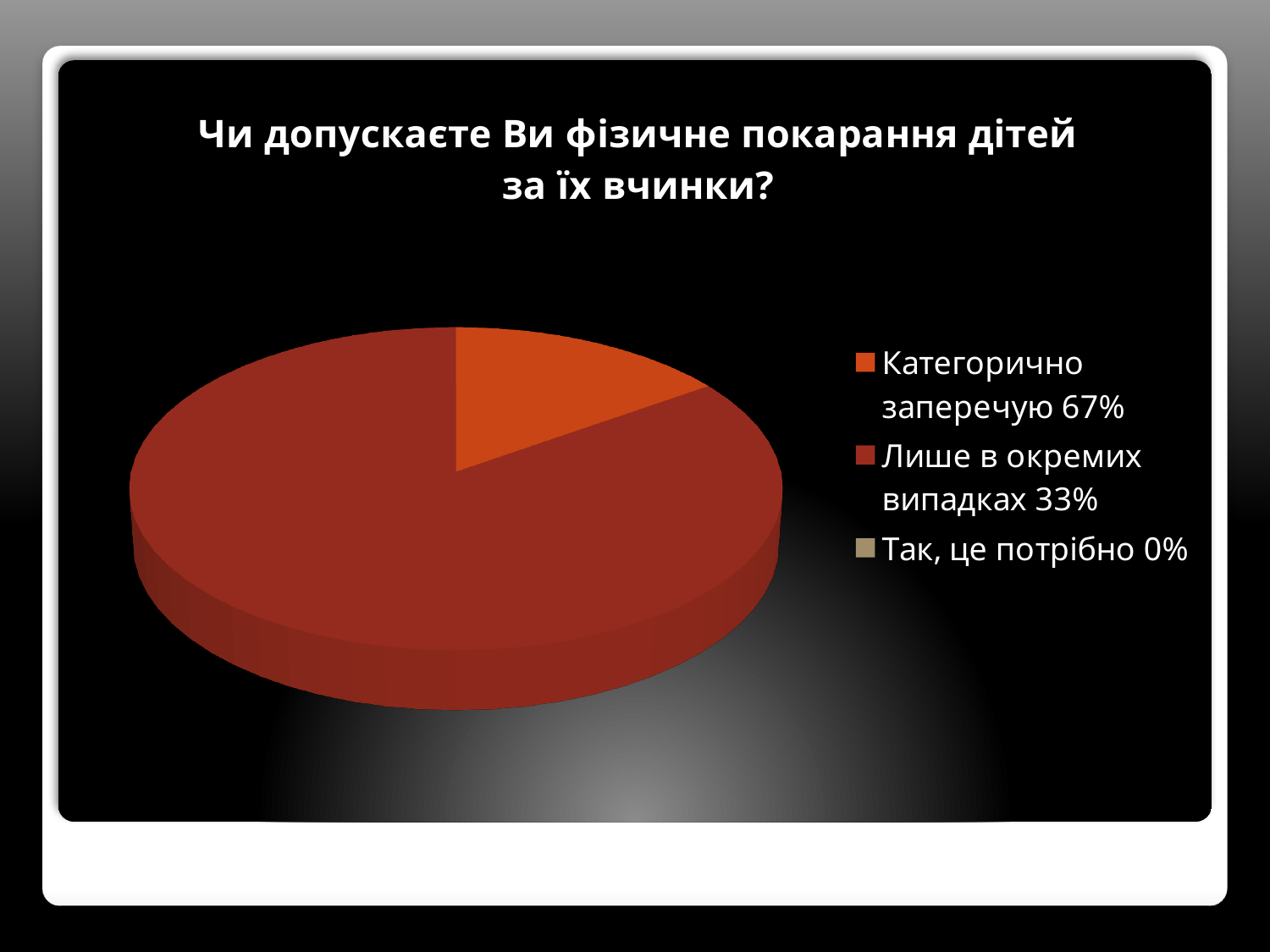
What percentage is shown in the legend for "Категорично заперечую"? 67% What colour is the legend marker for "Так, це потрібно 0%"? Tan/beige What percentage is shown in the legend for "Лише в окремих випадках"? 33% What is the difference in percentage points between "Категорично заперечую" and "Лише в окремих випадках" as printed in the legend? 34 What kind of chart is shown on the slide? Pie chart What is the title of the chart? Чи допускаєте Ви фізичне покарання дітей за їх вчинки? According to the legend, is the percentage for "Категорично заперечую" larger or smaller than that for "Лише в окремих випадках"? Larger What is the sum of the three percentages listed in the legend? 100% According to the legend, which category has the highest percentage? Категорично заперечую How many categories does the legend list? 3 According to the legend, which category has the lowest percentage? Так, це потрібно What percentage is shown in the legend for "Так, це потрібно"? 0%